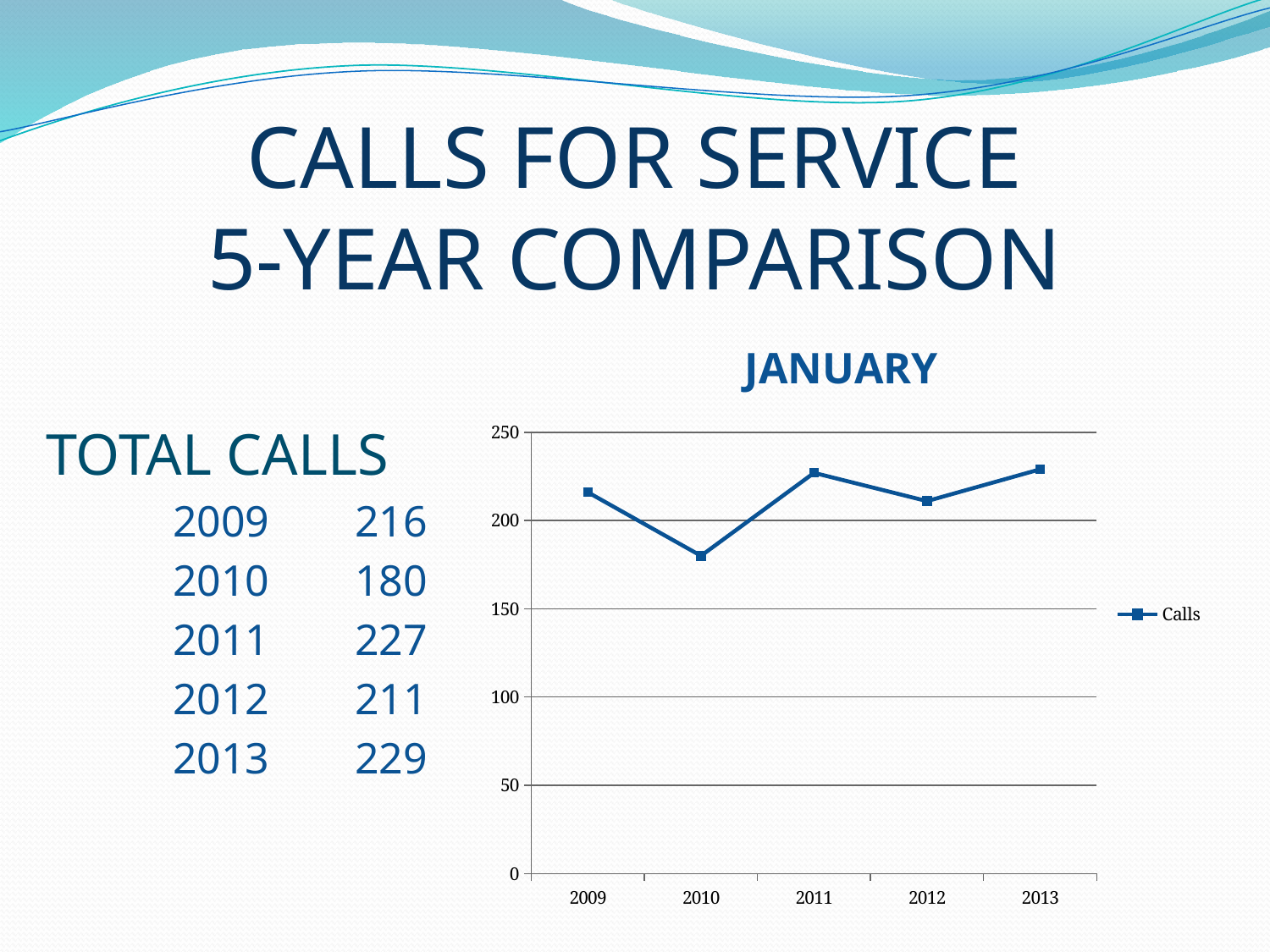
What kind of chart is shown on the slide? line chart What is the number of calls for 2013? 229 Which year had more calls, 2009 or 2012? 2009 Which year has the highest number of calls? 2013 Do the calls rise or fall from 2012 to 2013? rise What is the difference in calls between 2011 and 2010? 47 How many series does the chart legend list? 1 How many years are plotted on the x axis of the chart? 5 Is the value for 2010 greater or less than 200? less What is the title of the chart? JANUARY What is the number of calls for 2010? 180 Which year has the lowest number of calls? 2010